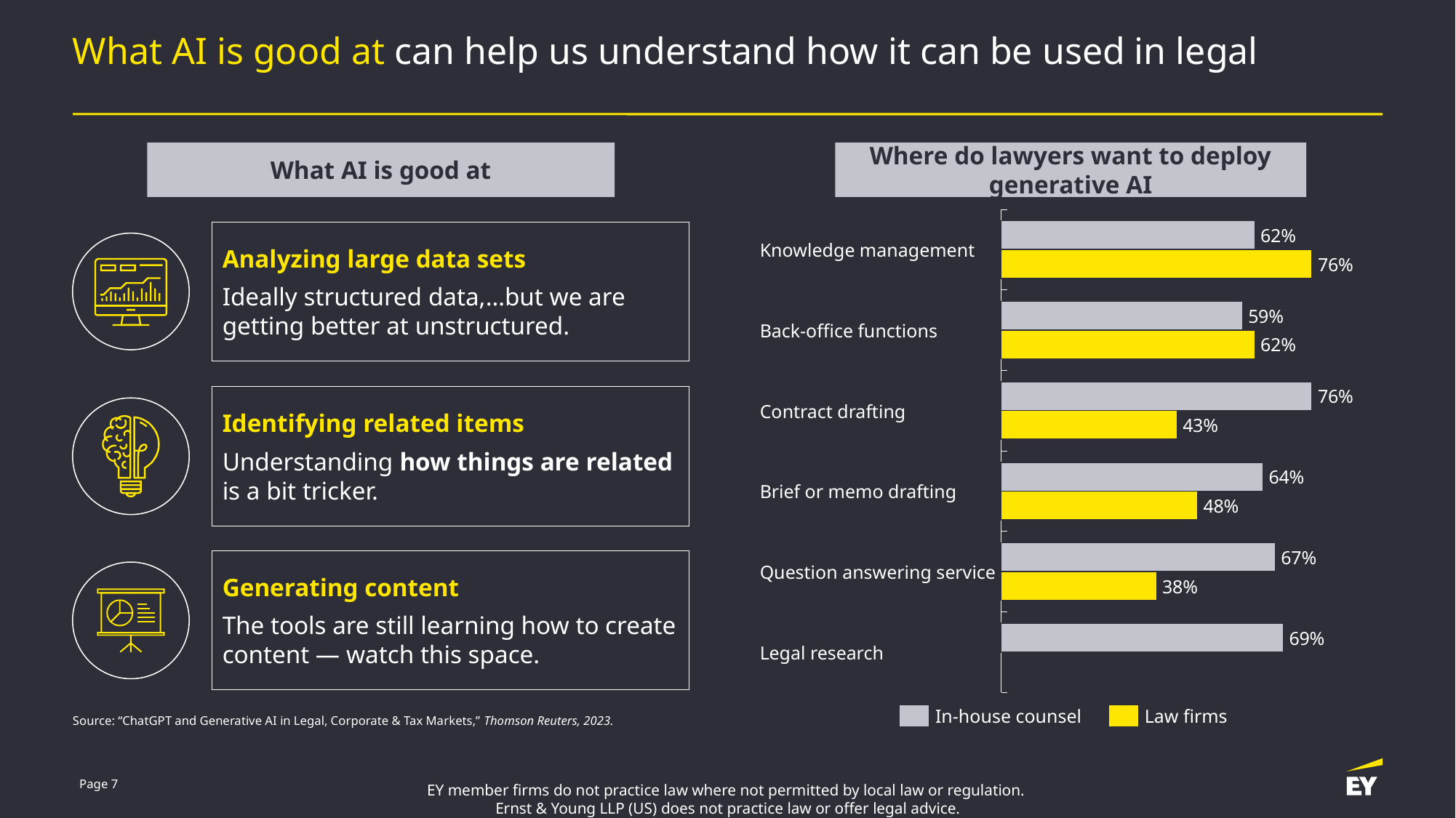
What is the value for In-house counsel for Legal research? 69% What percentage of law firms want to deploy generative AI for Contract drafting? 43% What is the difference between the In-house counsel and Law firms values for Contract drafting? 33% What is the value for Law firms for Question answering service? 38% Which category has the lowest value for In-house counsel? Back-office functions What percentage of in-house counsel want to deploy generative AI for Knowledge management? 62% How many series does the legend list? 2 How many categories are shown on the chart? 6 Which category has the lowest value for Law firms? Question answering service Which category has the highest value for In-house counsel? Contract drafting What kind of chart is shown on the slide? Bar chart For Knowledge management, which is larger: the In-house counsel value or the Law firms value? Law firms